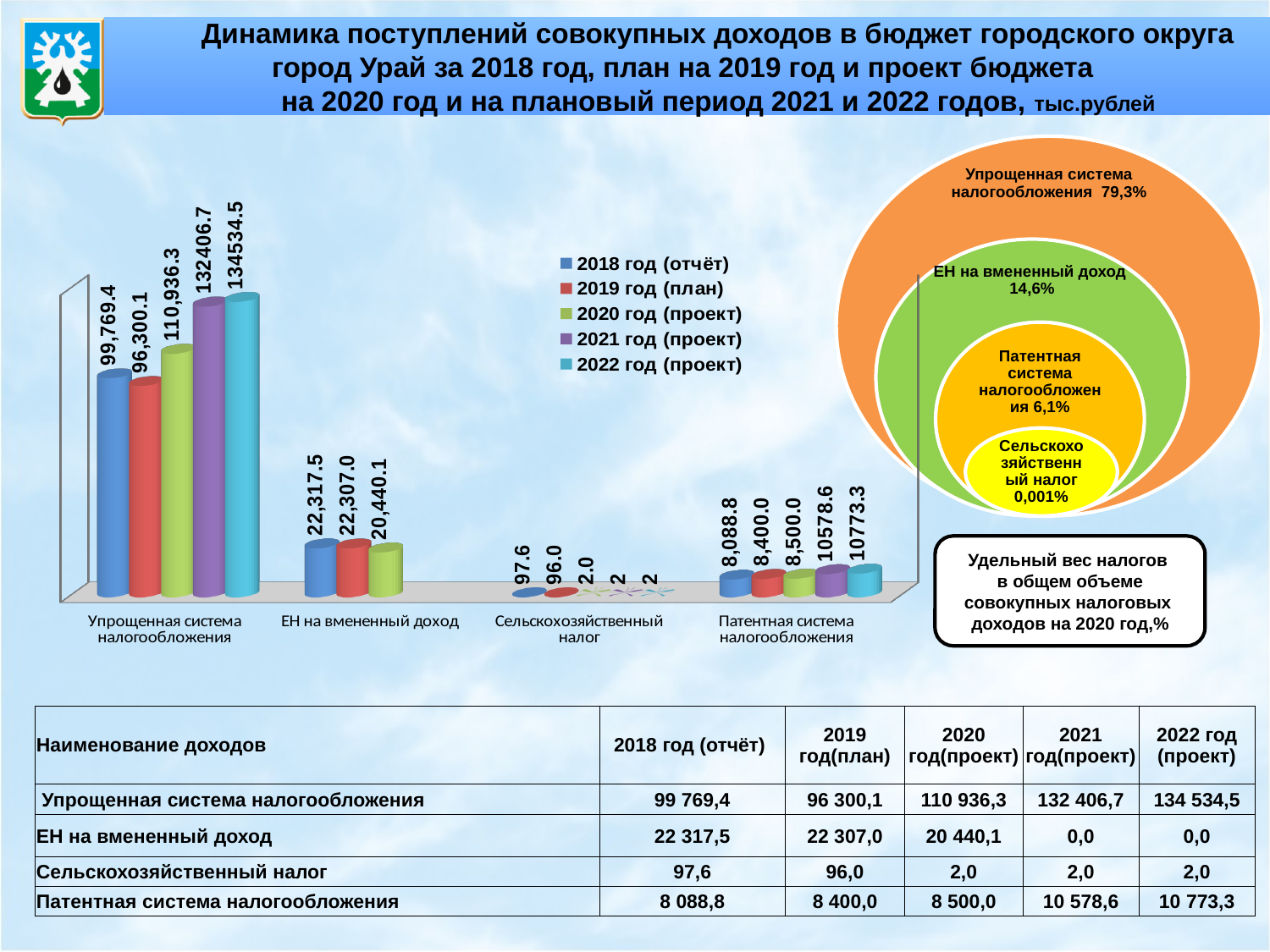
In the bar chart, which category has the lowest value for 2018 год (отчёт)? Сельскохозяйственный налог How many series does the legend of the bar chart list? 5 In the bar chart, what is the difference between the 2022 год (проект) and 2021 год (проект) values for Упрощенная система налогообложения? 2127.8 In the bar chart, what is the value for Патентная система налогообложения in 2022 год (проект)? 10773.3 In the bar chart, what is the value for ЕН на вмененный доход in 2020 год (проект)? 20,440.1 In the bar chart, what is the value for Упрощенная система налогообложения in 2018 год (отчёт)? 99,769.4 How many categories are shown on the x axis of the bar chart? 4 In the bar chart, which is larger for ЕН на вмененный доход: the 2018 год (отчёт) value or the 2019 год (план) value? 2018 год (отчёт) In the bar chart, which category has the highest value for 2022 год (проект)? Упрощенная система налогообложения In the bar chart, do the values for Патентная система налогообложения rise or fall from 2018 to 2022? Rise In the nested circle diagram on the right, what share does Упрощенная система налогообложения have? 79,3% What kind of chart is the chart on the left of the slide? Bar chart